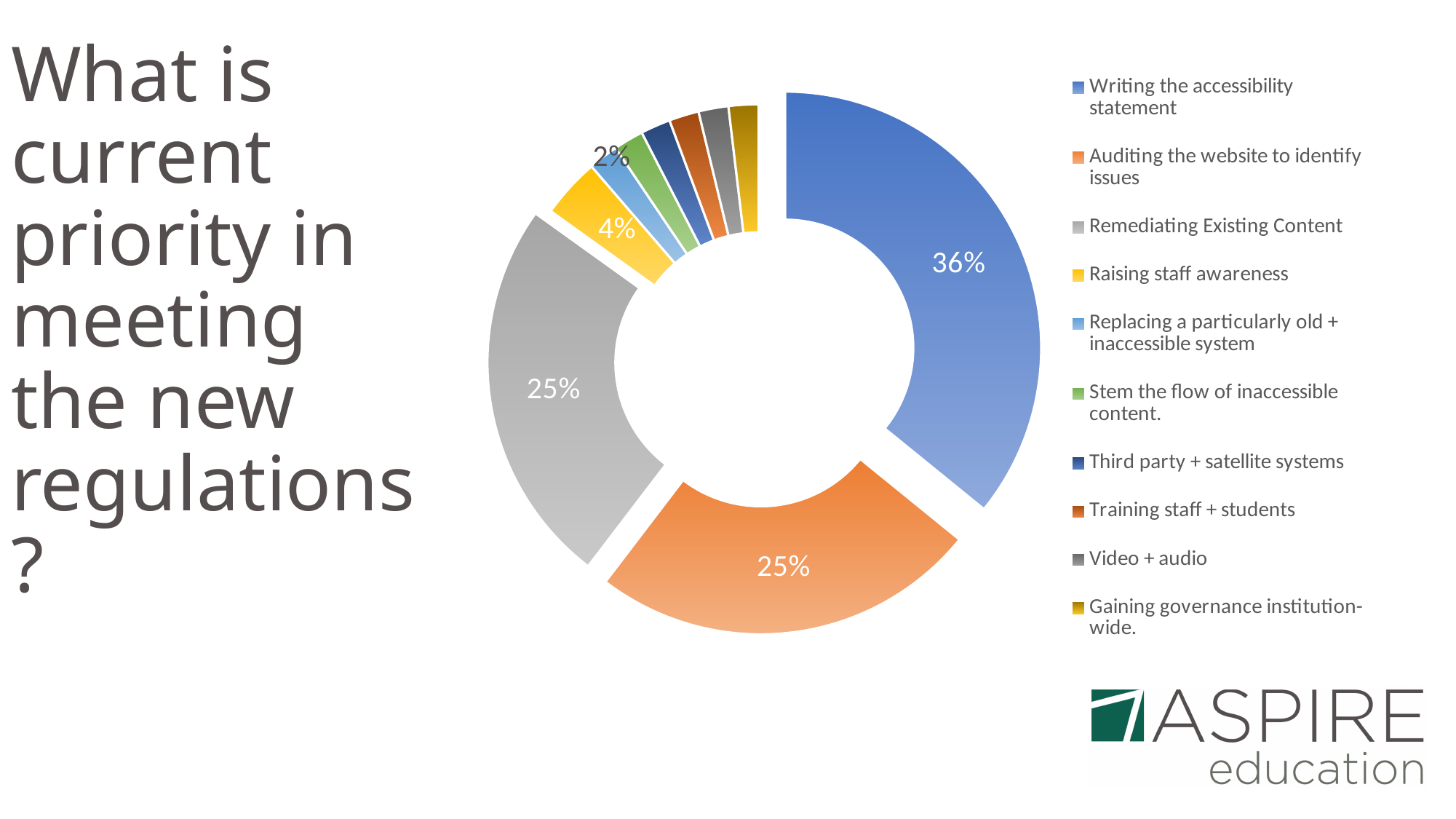
What is the difference in percentage points between Writing the accessibility statement and Auditing the website to identify issues? 11 percentage points Which priority has the largest share of the chart? Writing the accessibility statement What kind of chart is shown on the slide? Doughnut (pie) chart Which is larger: the share for Writing the accessibility statement or the share for Raising staff awareness? Writing the accessibility statement What colour represents Auditing the website to identify issues in the chart? Orange Is the share for Remediating Existing Content greater or less than the share for Raising staff awareness? greater What share is shown for Auditing the website to identify issues? 25% What percentage is labelled for Remediating Existing Content? 25% How many priorities are listed in the chart legend? 10 What percentage of the doughnut chart is for Writing the accessibility statement? 36% What percentage is shown for Raising staff awareness? 4% What percentage is labelled for Replacing a particularly old + inaccessible system? 2%